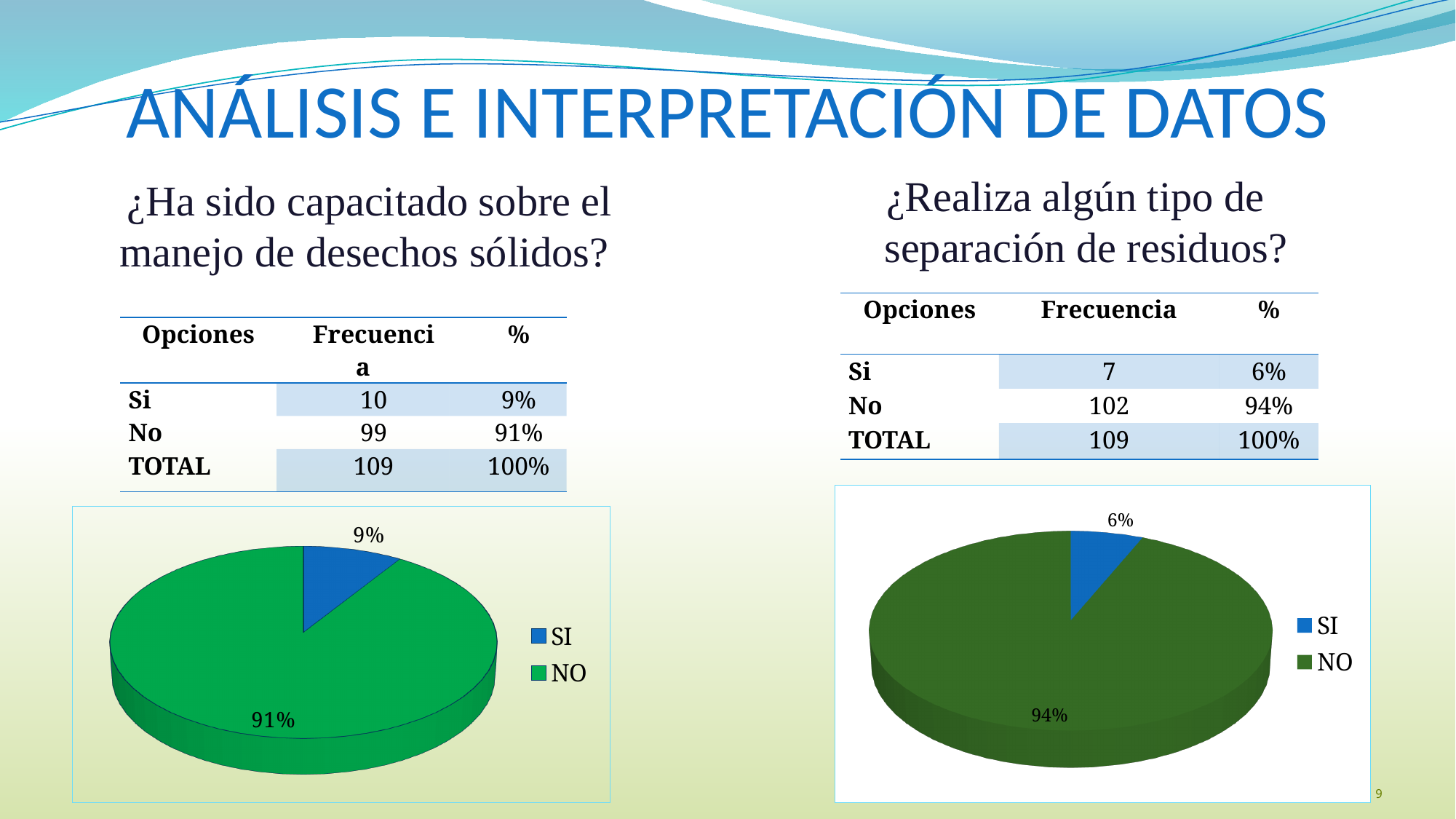
Is the SI slice larger in the left pie chart or in the right pie chart? Left pie chart In the right pie chart (¿Realiza algún tipo de separación de residuos?), what percentage is shown for the NO slice? 94% In the right pie chart, which category has the smallest slice? SI In the right pie chart, what colour is the NO slice? Dark green In the right pie chart (¿Realiza algún tipo de separación de residuos?), what percentage is shown for the SI slice? 6% In the left pie chart (¿Ha sido capacitado sobre el manejo de desechos sólidos?), what percentage is shown for the NO slice? 91% In the left pie chart (¿Ha sido capacitado sobre el manejo de desechos sólidos?), what percentage is shown for the SI slice? 9% What kind of chart is used on the left side of the slide? Pie chart In the left pie chart, what is the difference in percentage points between the NO slice and the SI slice? 82 In the left pie chart, which category has the largest slice? NO How many slices does the right pie chart have? 2 How many entries does the legend of the left pie chart list? 2